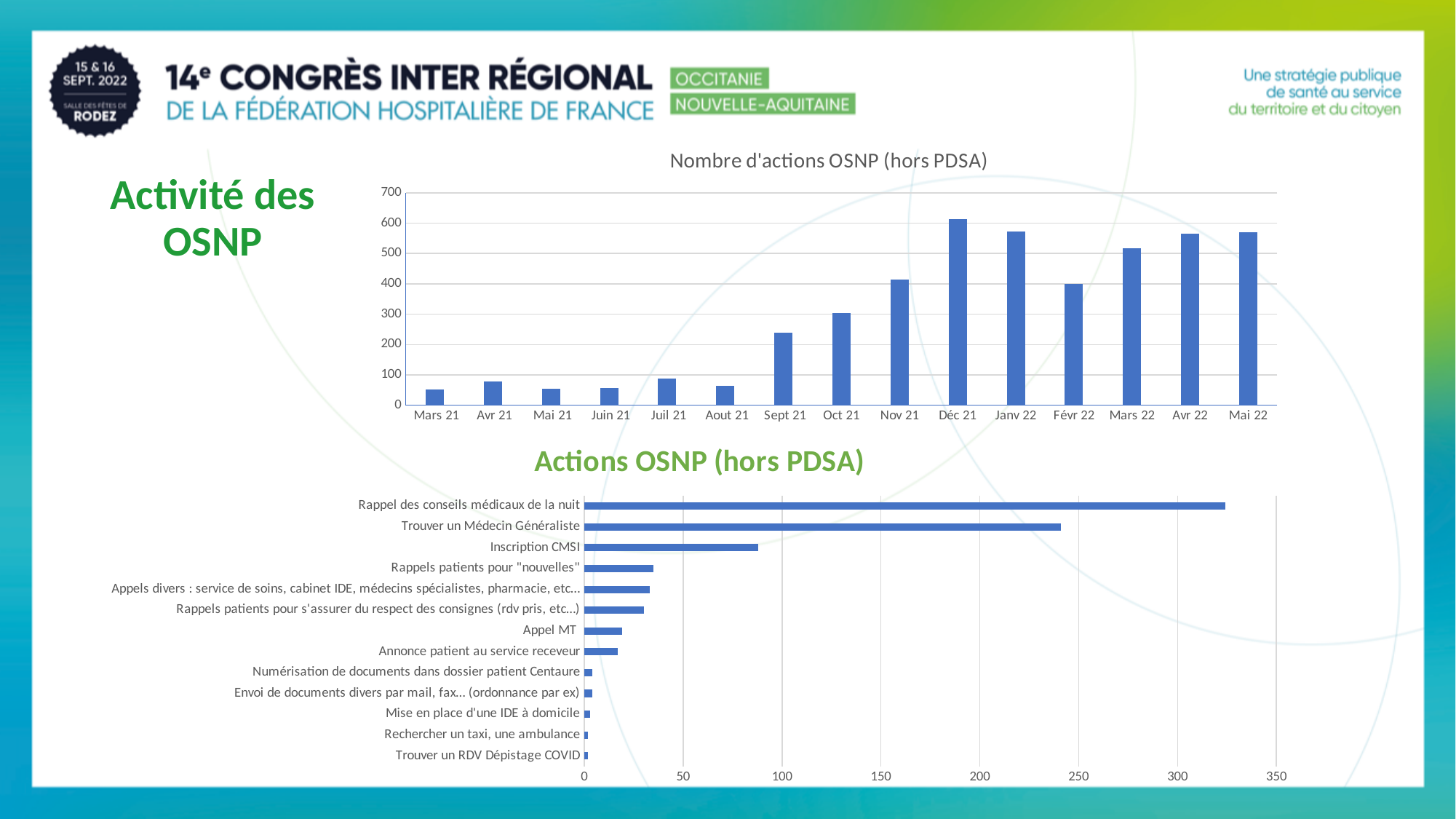
In the top chart "Nombre d'actions OSNP (hors PDSA)", is the value for Sept 21 greater or less than 200? greater In the top chart "Nombre d'actions OSNP (hors PDSA)", do the values generally rise or fall from Mars 21 to Déc 21? rise In the bottom chart "Actions OSNP (hors PDSA)", is the value for "Rappel des conseils médicaux de la nuit" greater or less than 300? greater In the top chart "Nombre d'actions OSNP (hors PDSA)", which month has the highest value? Déc 21 In the top chart "Nombre d'actions OSNP (hors PDSA)", which is larger, the value for Déc 21 or the value for Févr 22? Déc 21 In the bottom chart "Actions OSNP (hors PDSA)", how many action categories are listed? 13 What kind of chart is the bottom chart titled "Actions OSNP (hors PDSA)"? bar chart What kind of chart is the top chart titled "Nombre d'actions OSNP (hors PDSA)"? bar chart In the bottom chart "Actions OSNP (hors PDSA)", which category has the highest value? Rappel des conseils médicaux de la nuit In the bottom chart "Actions OSNP (hors PDSA)", which is larger, the value for "Trouver un Médecin Généraliste" or the value for "Inscription CMSI"? Trouver un Médecin Généraliste In the top chart "Nombre d'actions OSNP (hors PDSA)", how many months are shown on the x axis? 15 In the top chart "Nombre d'actions OSNP (hors PDSA)", is the value for Janv 22 greater or less than 500? greater